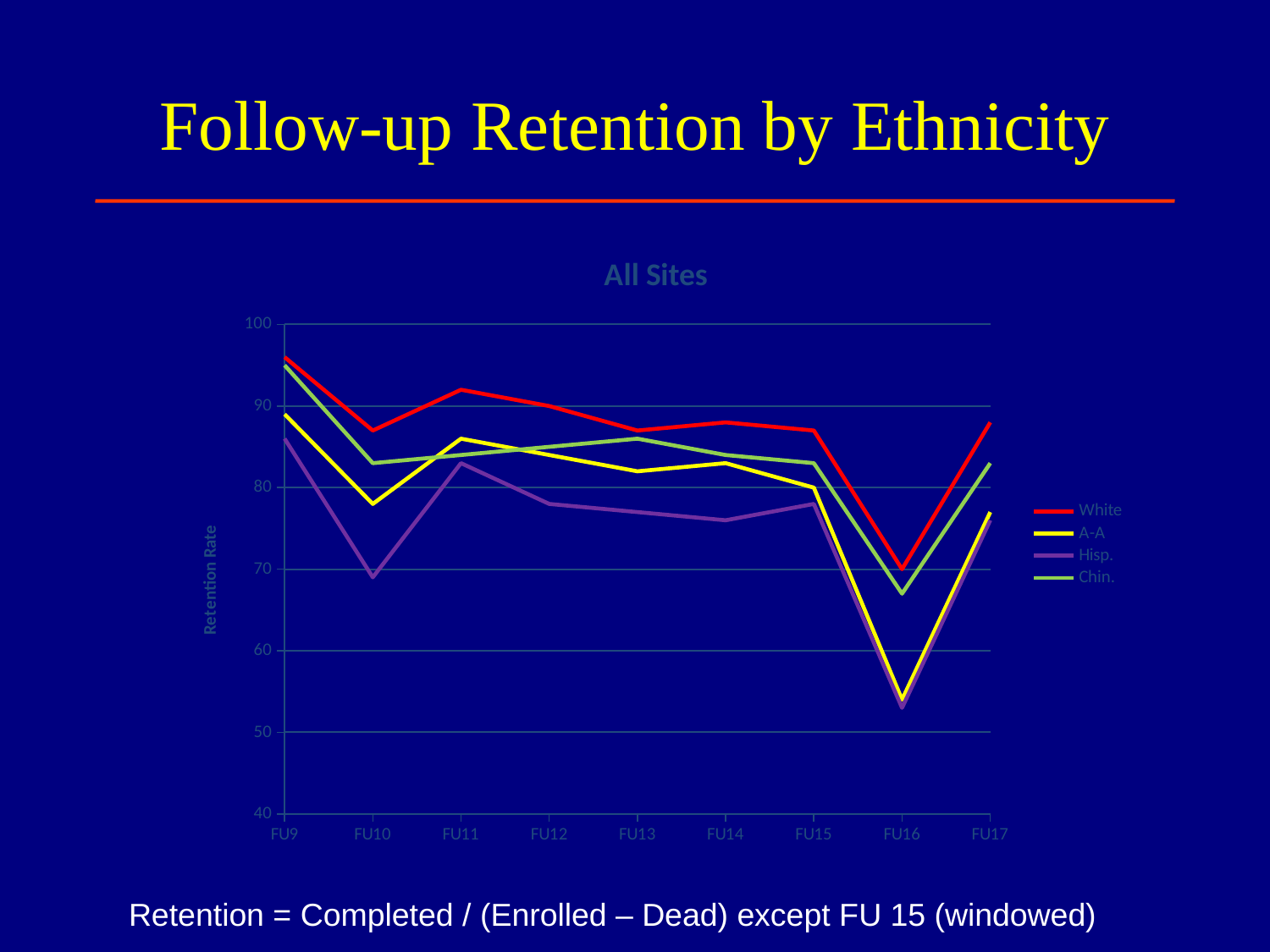
How many series does the legend list? 4 What is the title shown above the chart? All Sites Is the value for A-A at FU16 greater or less than 60? less What is the label on the vertical axis? Retention Rate At which follow-up is the White series at its lowest? FU16 How many follow-up points are plotted along the x axis? 9 Does the White series rise or fall from FU15 to FU16? fall At FU10, which series has the higher value, A-A or Hisp.? A-A At which follow-up is the Hisp. series at its lowest? FU16 What kind of chart is shown on the slide? line chart At FU16, which series has the higher value, White or Hisp.? White Is the value for White at FU9 greater or less than 90? greater